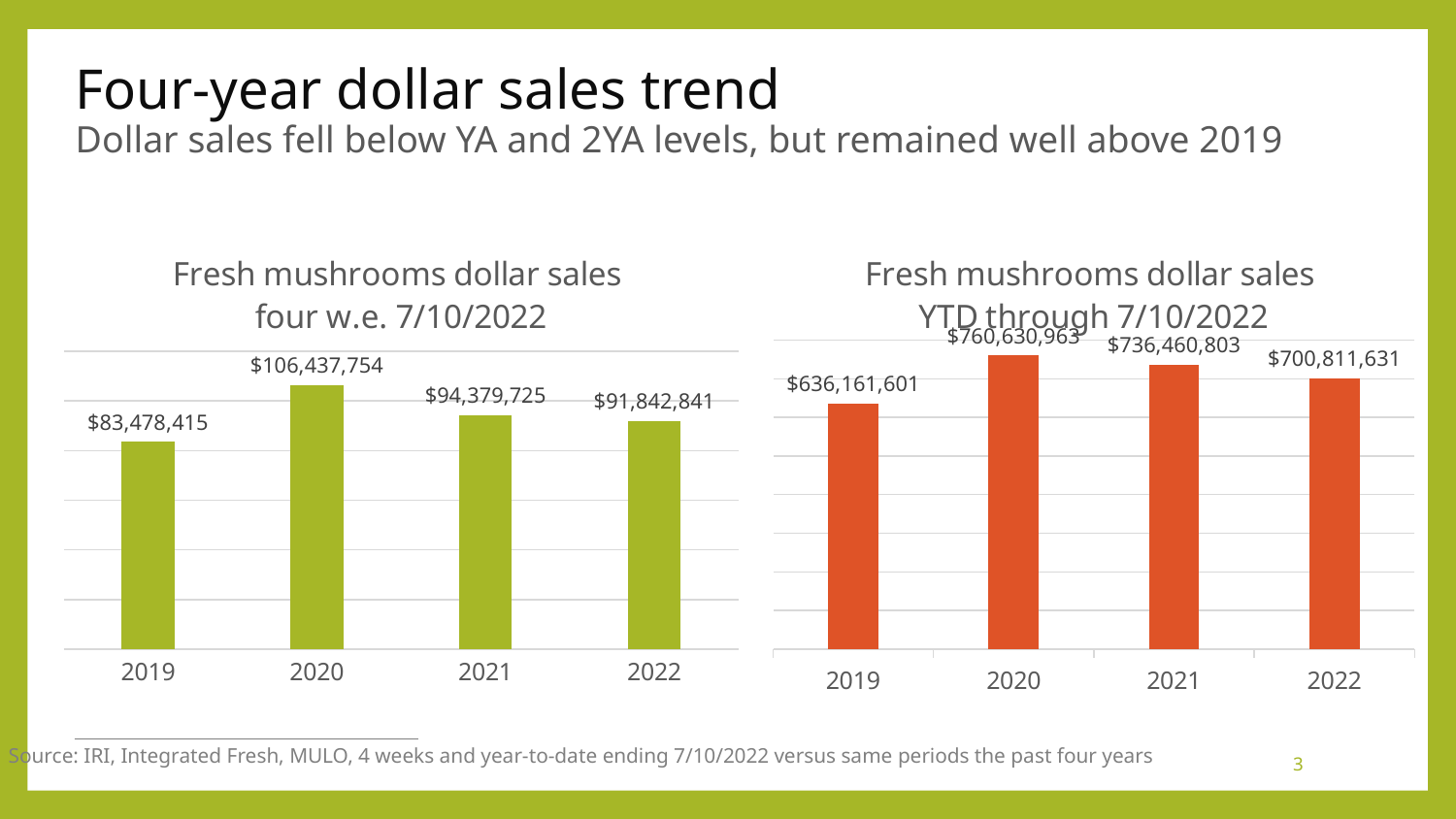
In the 'Fresh mushrooms dollar sales YTD through 7/10/2022' chart, which is larger, the value for 2021 or the value for 2022? 2021 What kind of chart is the 'Fresh mushrooms dollar sales YTD through 7/10/2022' chart? Bar chart How many years are shown on the x axis of the 'Fresh mushrooms dollar sales four w.e. 7/10/2022' chart? 4 In the 'Fresh mushrooms dollar sales four w.e. 7/10/2022' chart, which year has the lowest value? 2019 In the 'Fresh mushrooms dollar sales YTD through 7/10/2022' chart, what is the difference between the 2020 and 2022 values? $59,819,332 In the 'Fresh mushrooms dollar sales four w.e. 7/10/2022' chart, what is the difference between the 2020 and 2019 values? $22,959,339 In the 'Fresh mushrooms dollar sales four w.e. 7/10/2022' chart, what is the value for 2019? $83,478,415 In the 'Fresh mushrooms dollar sales YTD through 7/10/2022' chart, what is the value for 2021? $736,460,803 In the 'Fresh mushrooms dollar sales YTD through 7/10/2022' chart, which year has the highest value? 2020 In the 'Fresh mushrooms dollar sales four w.e. 7/10/2022' chart, which year has the highest value? 2020 In the 'Fresh mushrooms dollar sales YTD through 7/10/2022' chart, what is the value for 2019? $636,161,601 In the 'Fresh mushrooms dollar sales four w.e. 7/10/2022' chart, what is the value for 2022? $91,842,841